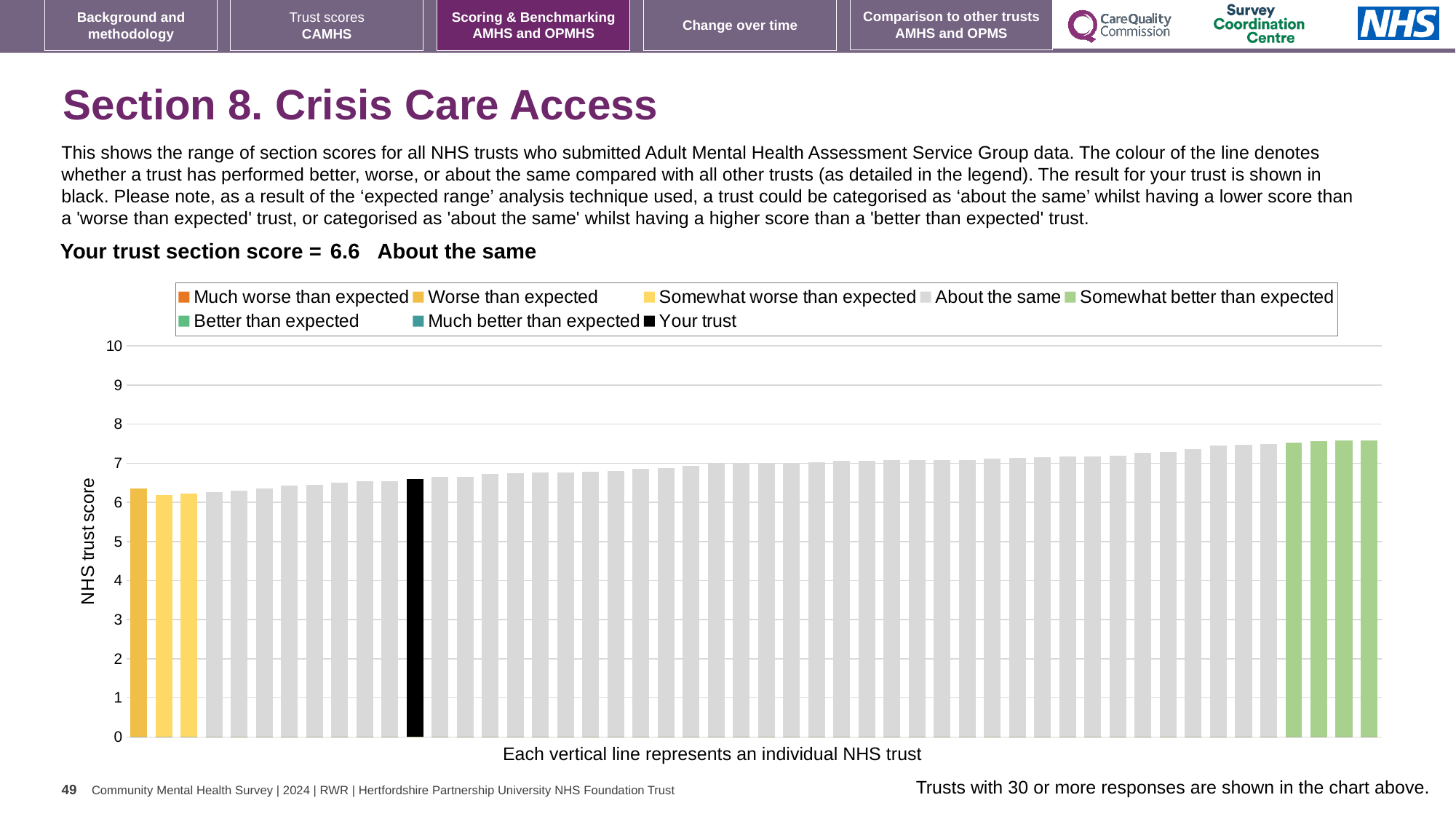
What is the section score for your trust shown on the slide? 6.6 Is the shortest bar in the chart greater or less than 5? greater What is the label on the vertical axis of the chart? NHS trust score What colour is the bar representing your trust? black What kind of chart is shown on the slide? bar chart Which category is your trust placed in for this section? About the same How many entries does the chart legend list? 8 Do the bar values rise or fall from left to right along the x axis? rise Is the value for your trust greater or less than 7? less How many bars are coloured green (somewhat better than expected)? 4 Is the tallest bar in the chart greater or less than 8? less